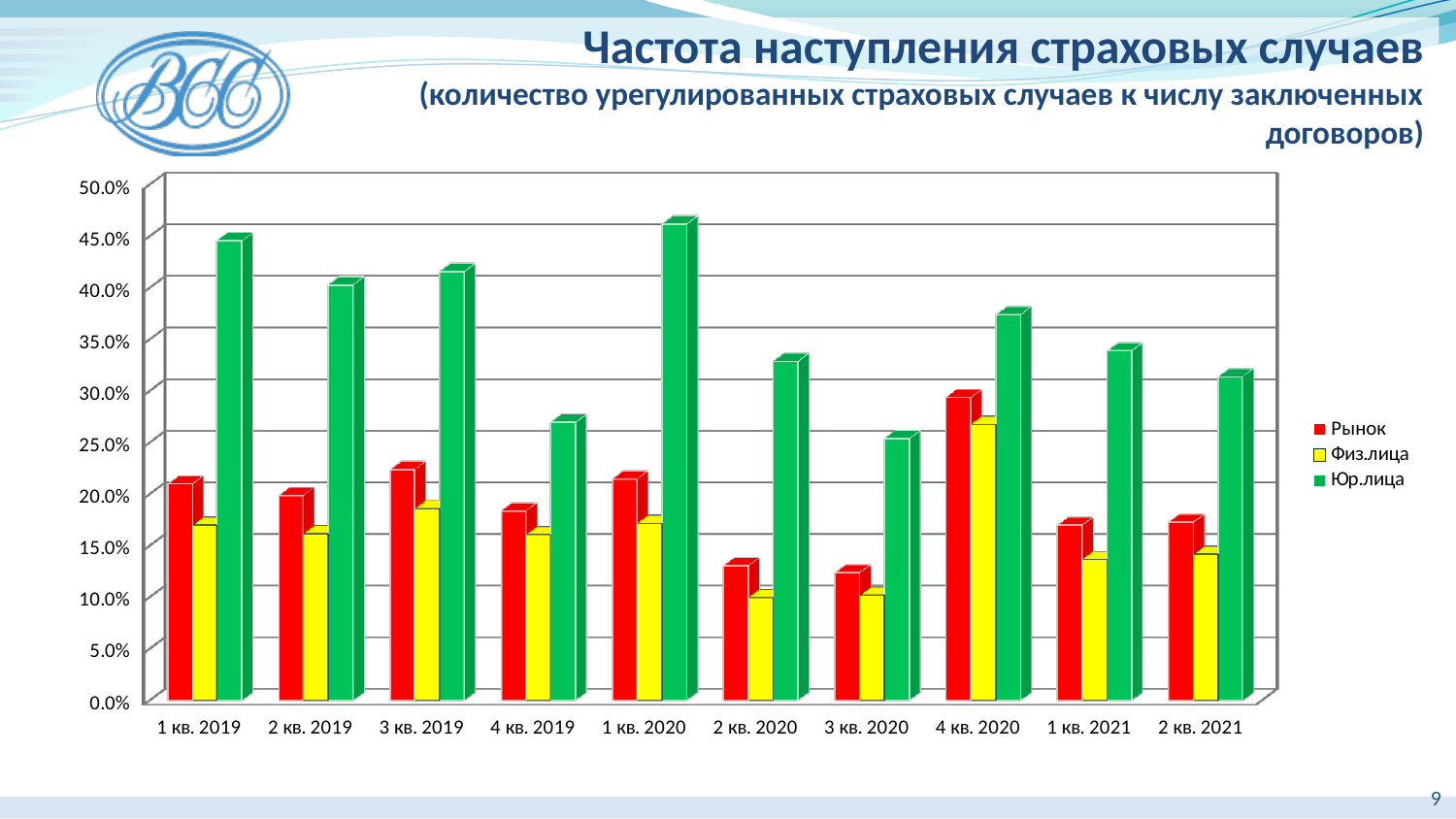
Which is larger in 4 кв. 2020: the value for Рынок or the value for Физ.лица? Рынок Is the value for Юр.лица in 1 кв. 2019 greater or less than 40.0%? greater Is the value for Рынок in 4 кв. 2020 greater or less than 25.0%? greater Is the value for Физ.лица in 2 кв. 2020 greater or less than 15.0%? less How many series does the legend list? 3 What kind of chart is shown on the slide? bar chart Does the value for Рынок rise or fall from 1 кв. 2020 to 3 кв. 2020? fall Which colour represents the Юр.лица series? green In which quarter is the value for Юр.лица the lowest? 3 кв. 2020 How many quarters (categories) are shown on the x axis? 10 In which quarter is the value for Юр.лица the highest? 1 кв. 2020 In which quarter is the value for Рынок the highest? 4 кв. 2020